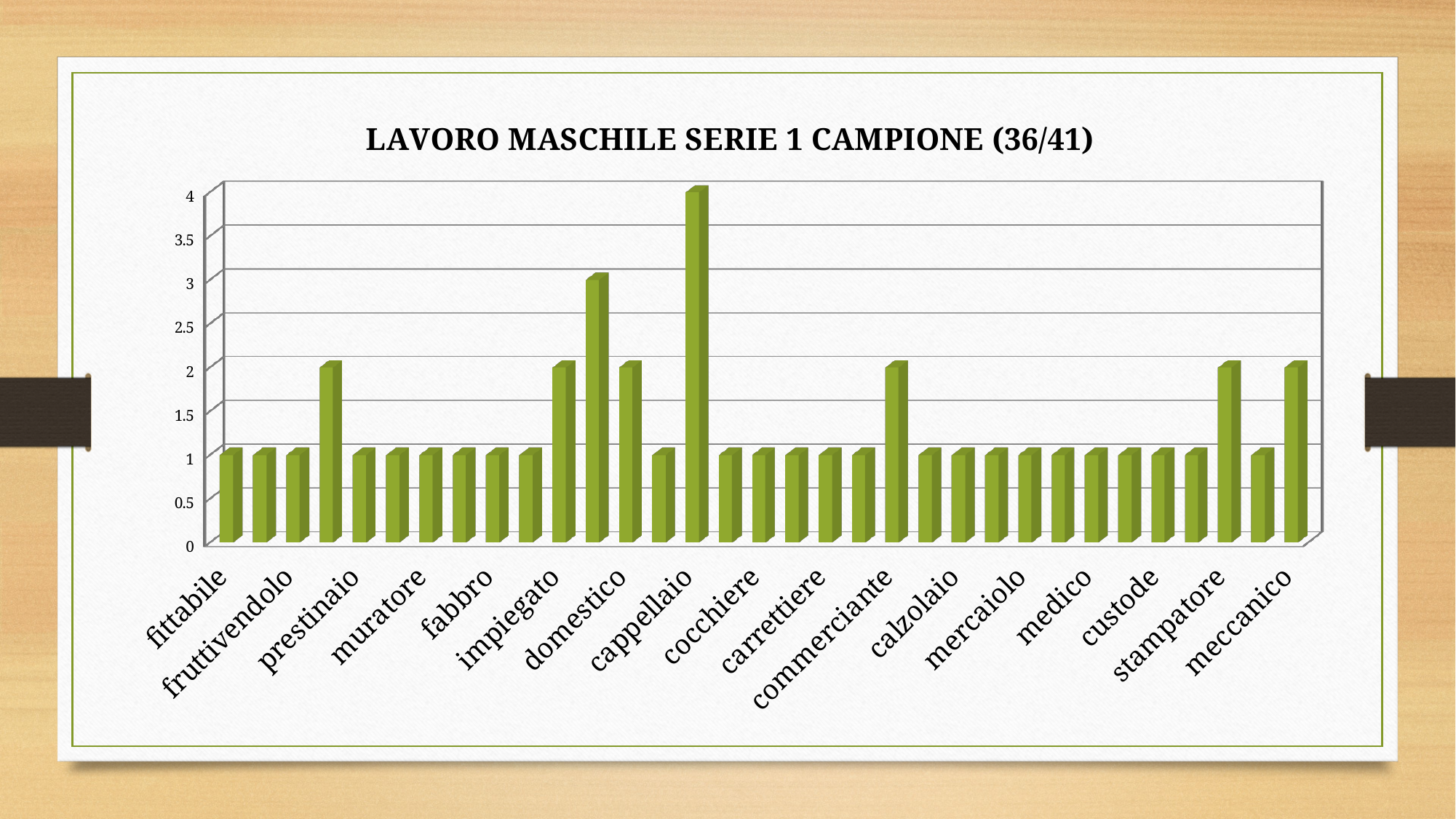
What is the title of the chart? LAVORO MASCHILE SERIE 1 CAMPIONE (36/41) What is the maximum value shown on the vertical axis? 4 Which is larger, the value for cappellaio or the value for commerciante? cappellaio Is the value for medico greater or less than 2? less Which category has the highest bar? cappellaio Is the value for cappellaio greater or less than 3? greater What is the value for meccanico? 2 What is the value for cappellaio? 4 What kind of chart is shown on the slide? bar chart What is the value for fittabile? 1 What is the difference between the value for cappellaio and the value for fittabile? 3 What is the value for impiegato? 2